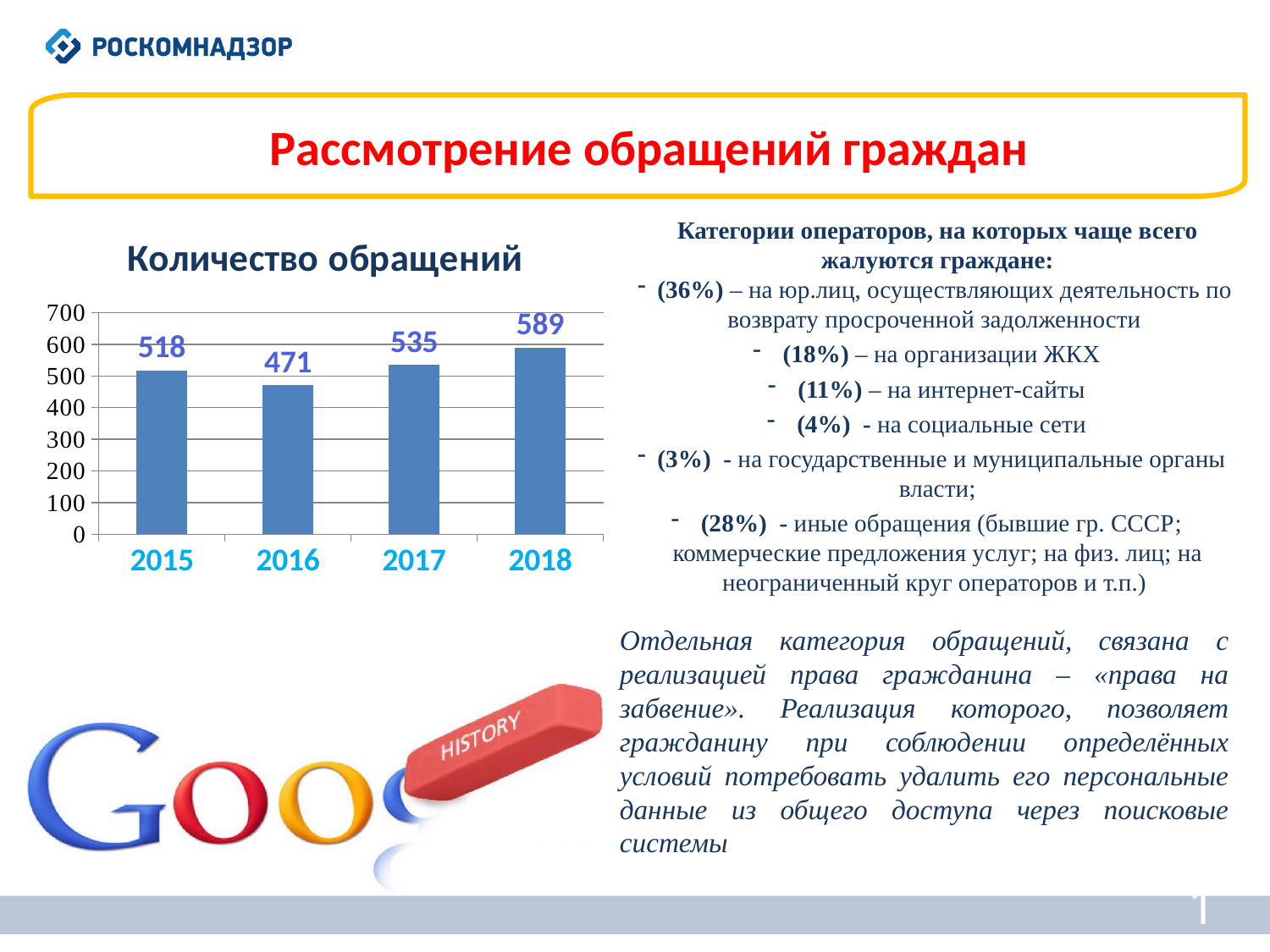
Is the value for 2016 greater or less than 500? less How many years are shown in the chart? 4 What kind of chart is shown on the slide? bar chart What is the value for 2016 in the chart? 471 Which year has the lowest number of appeals? 2016 What is the value for 2018 in the chart? 589 What is the difference between the values for 2018 and 2016? 118 What is the value for 2015 in the chart? 518 What is the title of the chart? Количество обращений Which year has the highest number of appeals? 2018 Which is larger, the value for 2015 or the value for 2017? 2017 What is the value for 2017 in the chart? 535